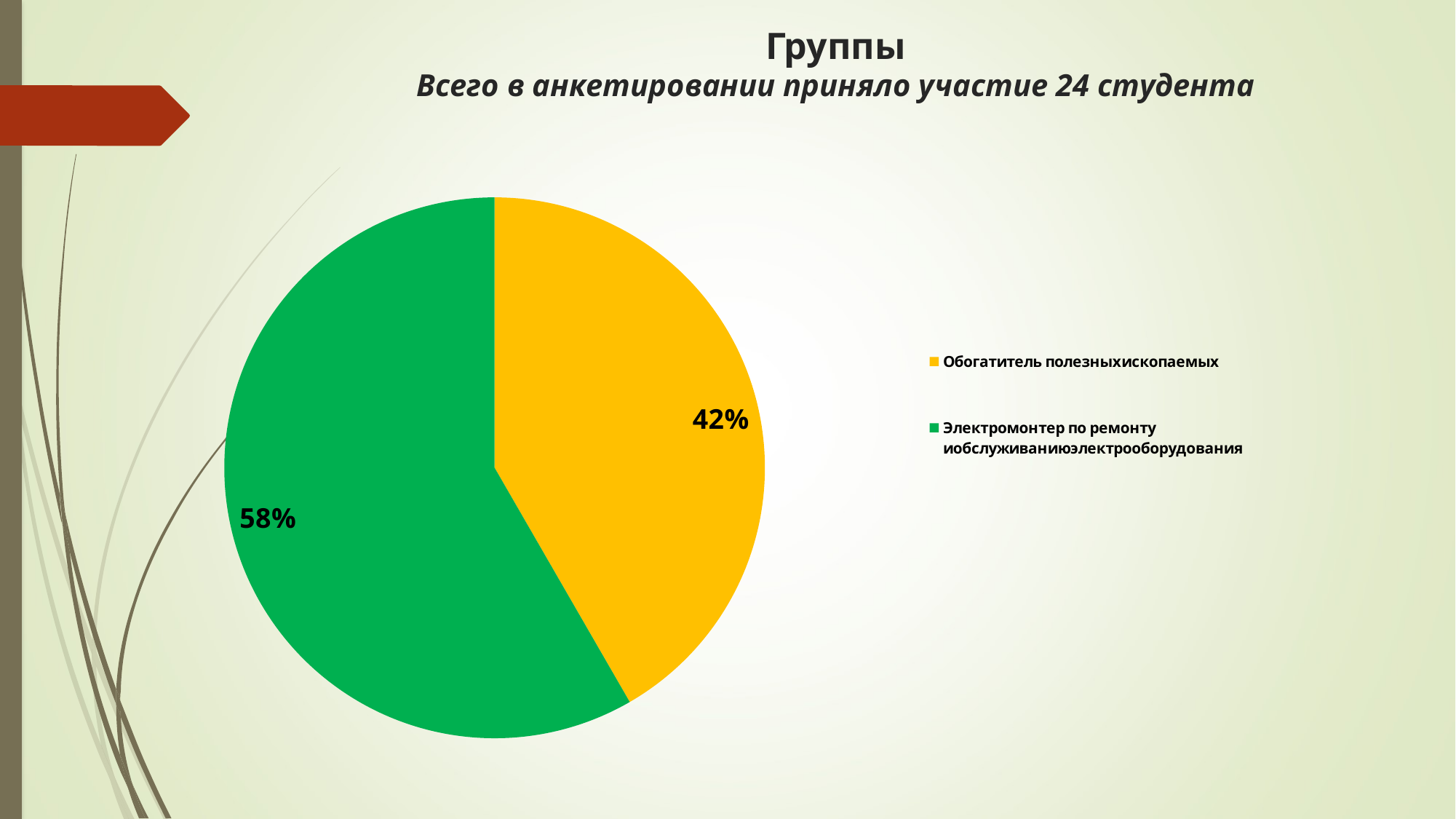
Which group has the smallest slice of the pie? Обогатитель полезныхископаемых What is the title of the chart? Группы How many slices does the pie chart have? 2 Which slice is larger: "Обогатитель полезныхископаемых" or "Электромонтер по ремонту иобслуживаниюэлектрооборудования"? Электромонтер по ремонту иобслуживаниюэлектрооборудования How many entries does the legend list? 2 Is the share for "Электромонтер по ремонту иобслуживаниюэлектрооборудования" greater or less than 50%? greater What share of the pie does "Обогатитель полезныхископаемых" have? 42% What kind of chart is shown on the slide? pie chart What is the difference in percentage points between the two slices? 16 What share of the pie does "Электромонтер по ремонту иобслуживаниюэлектрооборудования" have? 58% Which group has the largest slice of the pie? Электромонтер по ремонту иобслуживаниюэлектрооборудования What colour is the slice for "Обогатитель полезныхископаемых"? yellow